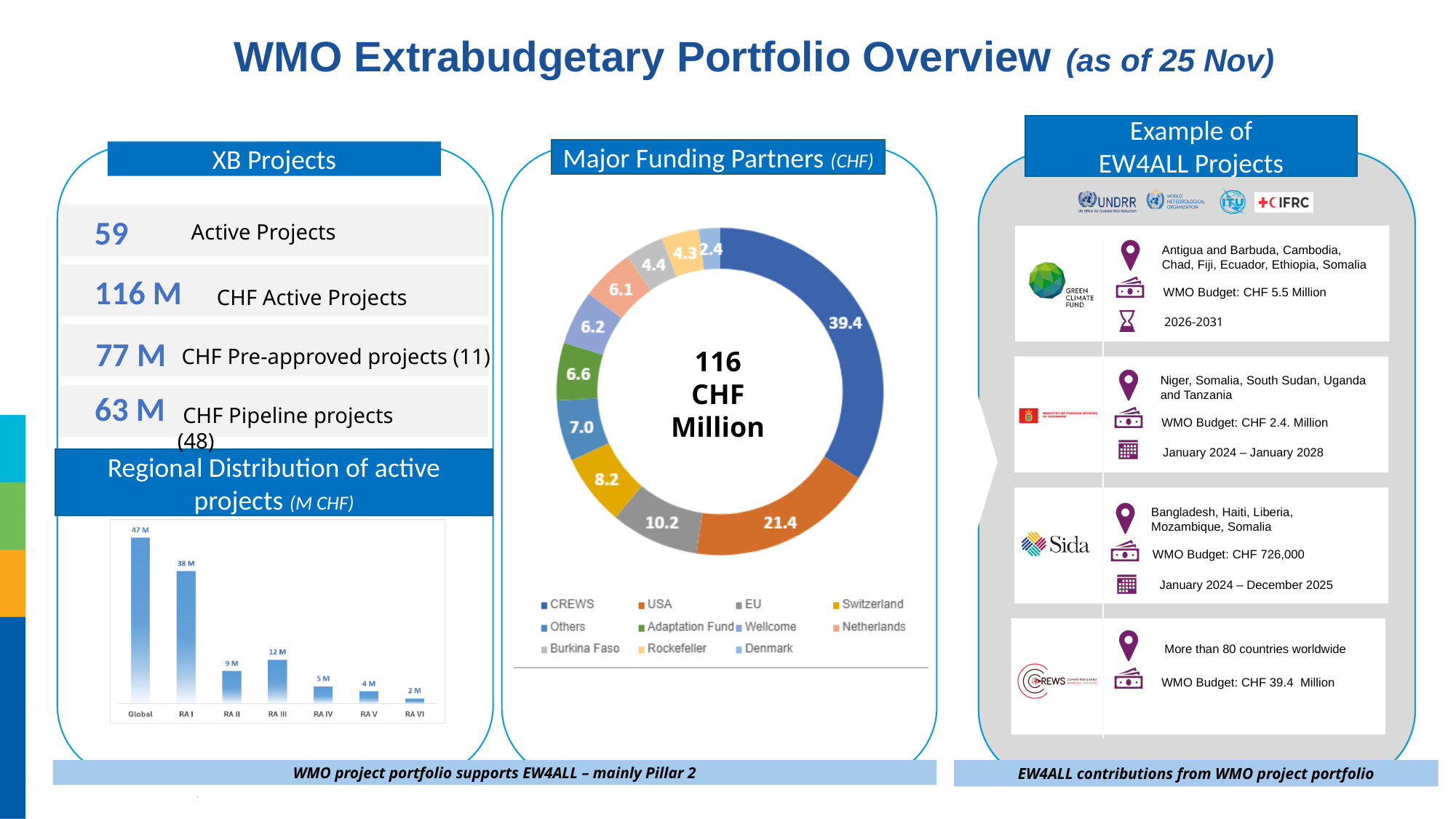
In the Regional Distribution of active projects chart, what is the difference between the values for Global and RA I? 9 M How many entries does the legend of the Major Funding Partners chart list? 11 In the Regional Distribution of active projects chart, which category has the highest value? Global In the Regional Distribution of active projects chart, how many categories are shown on the x axis? 7 In the Regional Distribution of active projects chart, what is the value for RA III? 12 M What kind of chart is the Regional Distribution of active projects chart? Bar chart In the Major Funding Partners chart, which is larger, the value for EU or the value for Adaptation Fund? EU In the Major Funding Partners chart, what is the value for Switzerland? 8.2 In the Regional Distribution of active projects chart, what is the value for RA I? 38 M In the Major Funding Partners chart, what is the value for USA? 21.4 In the Major Funding Partners chart, which funding partner has the largest share? CREWS In the Regional Distribution of active projects chart, which category has the lowest value? RA VI